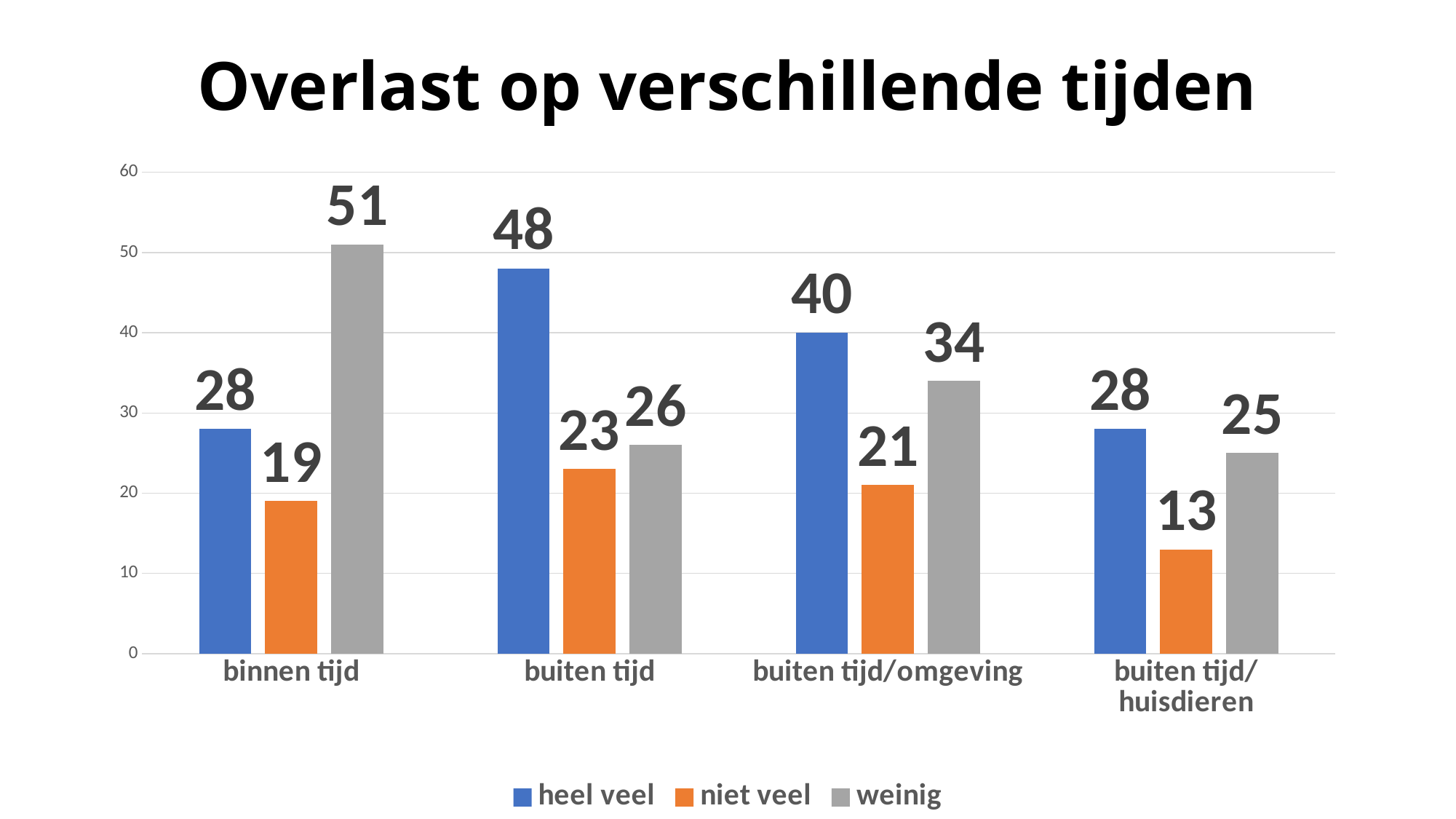
What is the title of the chart? Overlast op verschillende tijden Is the value for 'weinig' in the 'buiten tijd' category greater or less than 30? less How many series does the legend list? 3 What is the value for 'weinig' in the 'binnen tijd' category? 51 Which category has the highest value for 'heel veel'? buiten tijd Which is larger in the 'buiten tijd/omgeving' category: 'heel veel' or 'weinig'? heel veel Which category has the lowest value for 'niet veel'? buiten tijd/huisdieren What is the difference between the 'weinig' value and the 'heel veel' value in the 'binnen tijd' category? 23 What is the value for 'niet veel' in the 'buiten tijd/huisdieren' category? 13 What kind of chart is shown on the slide? bar chart What is the value for 'heel veel' in the 'buiten tijd' category? 48 How many categories are shown on the x axis? 4